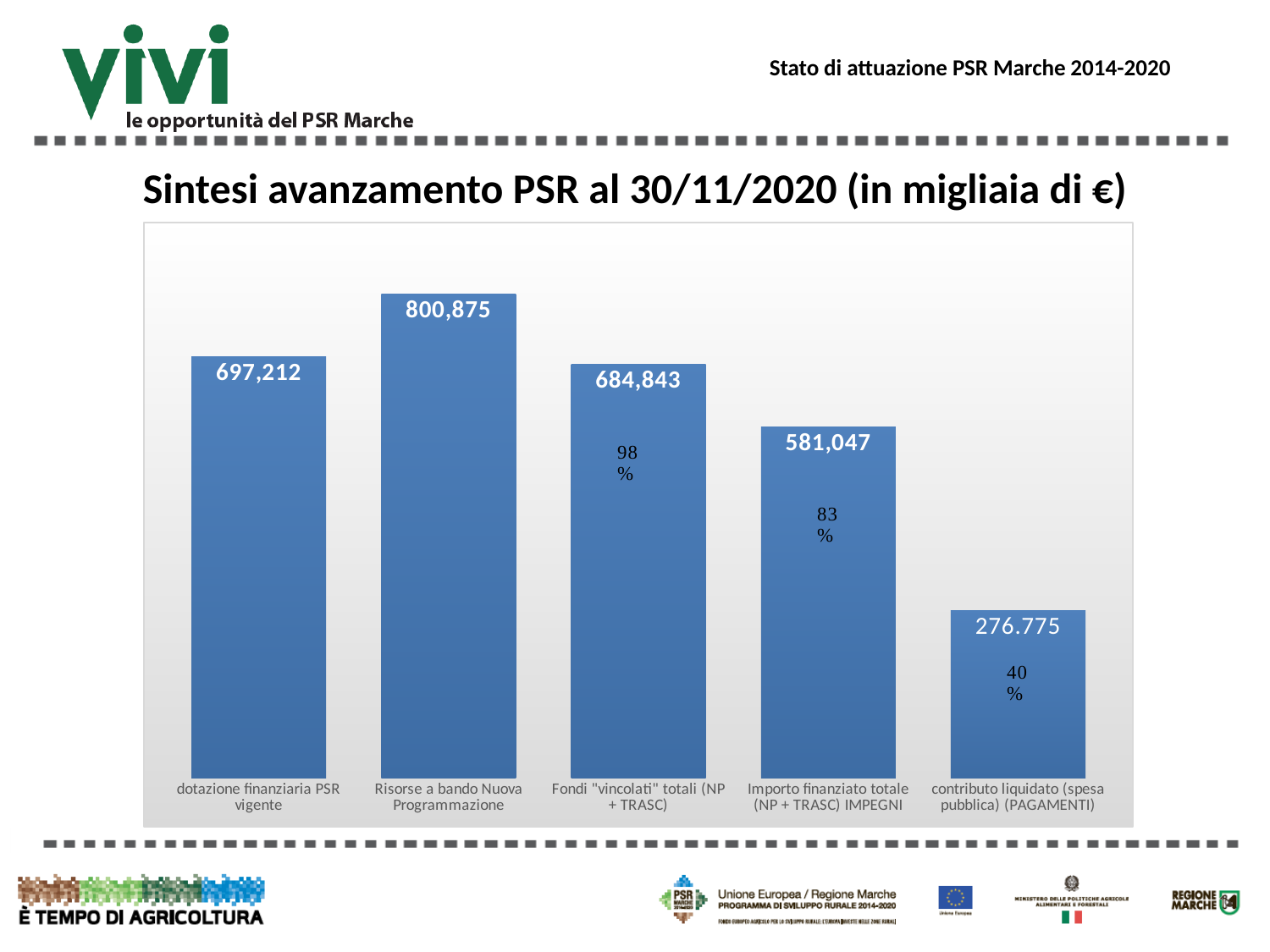
What is the value for "Fondi "vincolati" totali (NP + TRASC)"? 684,843 What is the value for "Importo finanziato totale (NP + TRASC) IMPEGNI"? 581,047 Which is larger: "Fondi "vincolati" totali (NP + TRASC)" or "Importo finanziato totale (NP + TRASC) IMPEGNI"? Fondi "vincolati" totali (NP + TRASC) What kind of chart is shown on the slide? bar chart What is the difference between "Risorse a bando Nuova Programmazione" and "dotazione finanziaria PSR vigente"? 103,663 What percentage is annotated on the bar for "contributo liquidato (spesa pubblica) (PAGAMENTI)"? 40% What is the value for "Risorse a bando Nuova Programmazione"? 800,875 What is the value for "dotazione finanziaria PSR vigente"? 697,212 How many categories are shown in the chart? 5 Which category has the lowest value? contributo liquidato (spesa pubblica) (PAGAMENTI) Which category has the highest value? Risorse a bando Nuova Programmazione What is the value for "contributo liquidato (spesa pubblica) (PAGAMENTI)"? 276.775